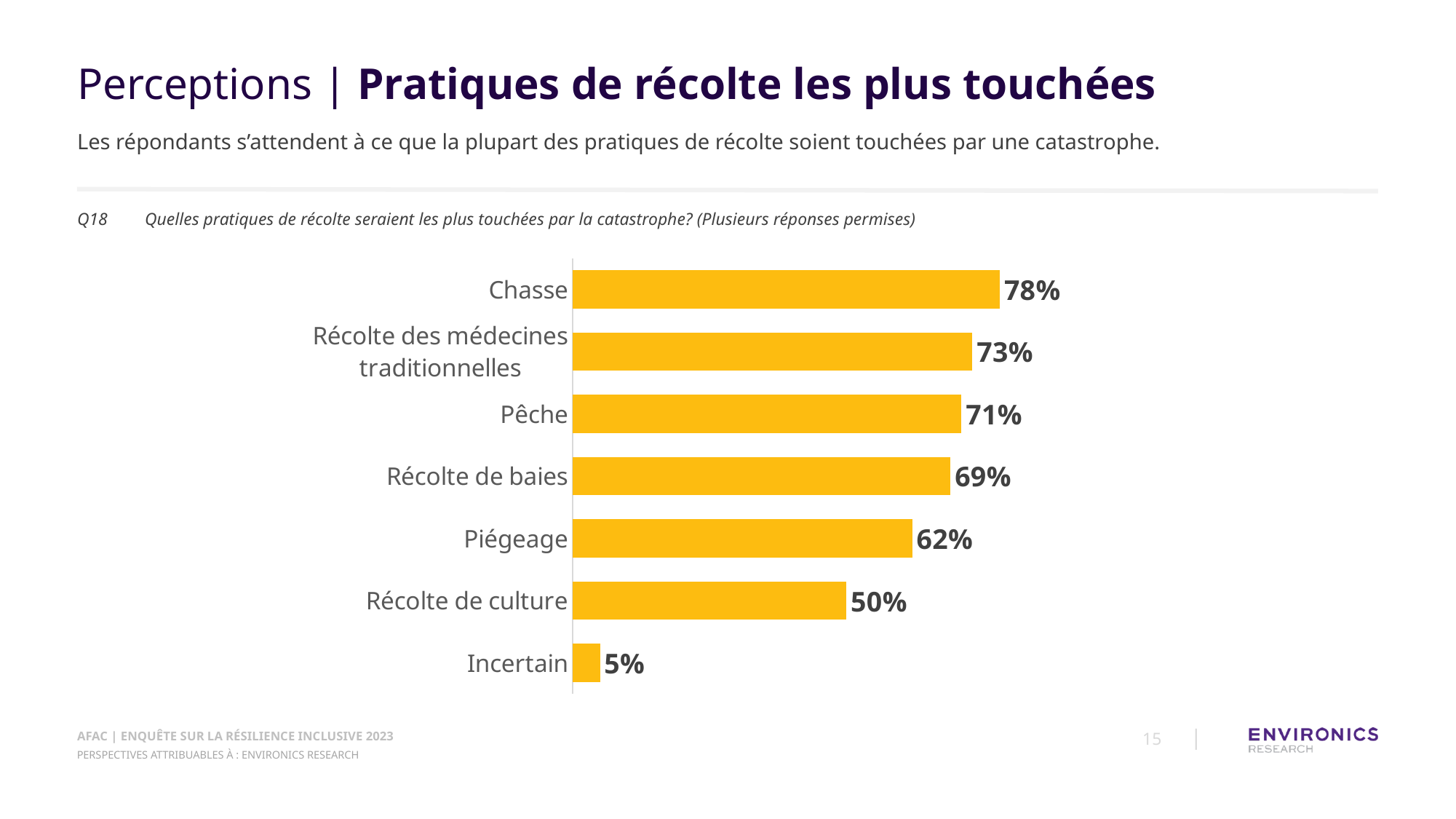
What is the value for Récolte de culture? 50% What is the value for Pêche? 71% Which is larger, the value for Piégeage or the value for Récolte de culture? Piégeage What is the value for Chasse? 78% What is the difference between the values for Récolte de baies and Récolte de culture? 19% What kind of chart is shown on the slide? Bar chart Which category has the lowest value? Incertain What colour are the bars in the chart? Yellow Which category has the highest value? Chasse What is the difference between the values for Chasse and Piégeage? 16% How many categories are shown in the chart? 7 What is the value for Récolte des médecines traditionnelles? 73%